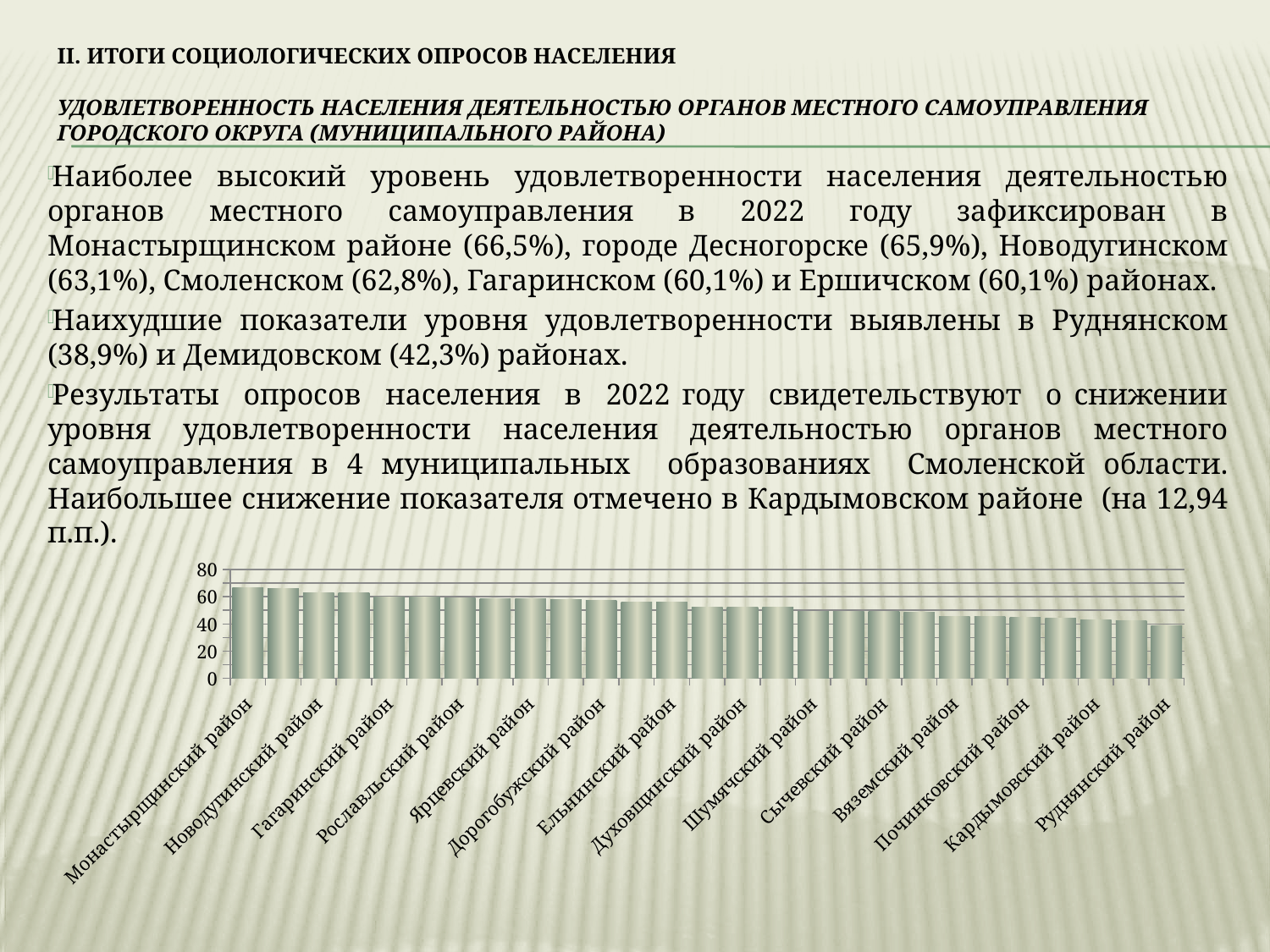
What kind of chart is shown at the bottom of the slide? bar chart Is the value for Монастырщинский район greater or less than 60? greater What is the highest value shown on the chart's vertical axis? 80 Which has the larger value in the chart, Новодугинский район or Кардымовский район? Новодугинский район Is the value for Ельнинский район greater or less than 60? less Is the value for Шумячский район greater or less than 40? greater Which has the larger value in the chart, Монастырщинский район or Руднянский район? Монастырщинский район Which district has the highest bar in the chart? Монастырщинский район Do the bar values rise or fall from left to right along the x axis? fall Which district has the lowest bar in the chart? Руднянский район